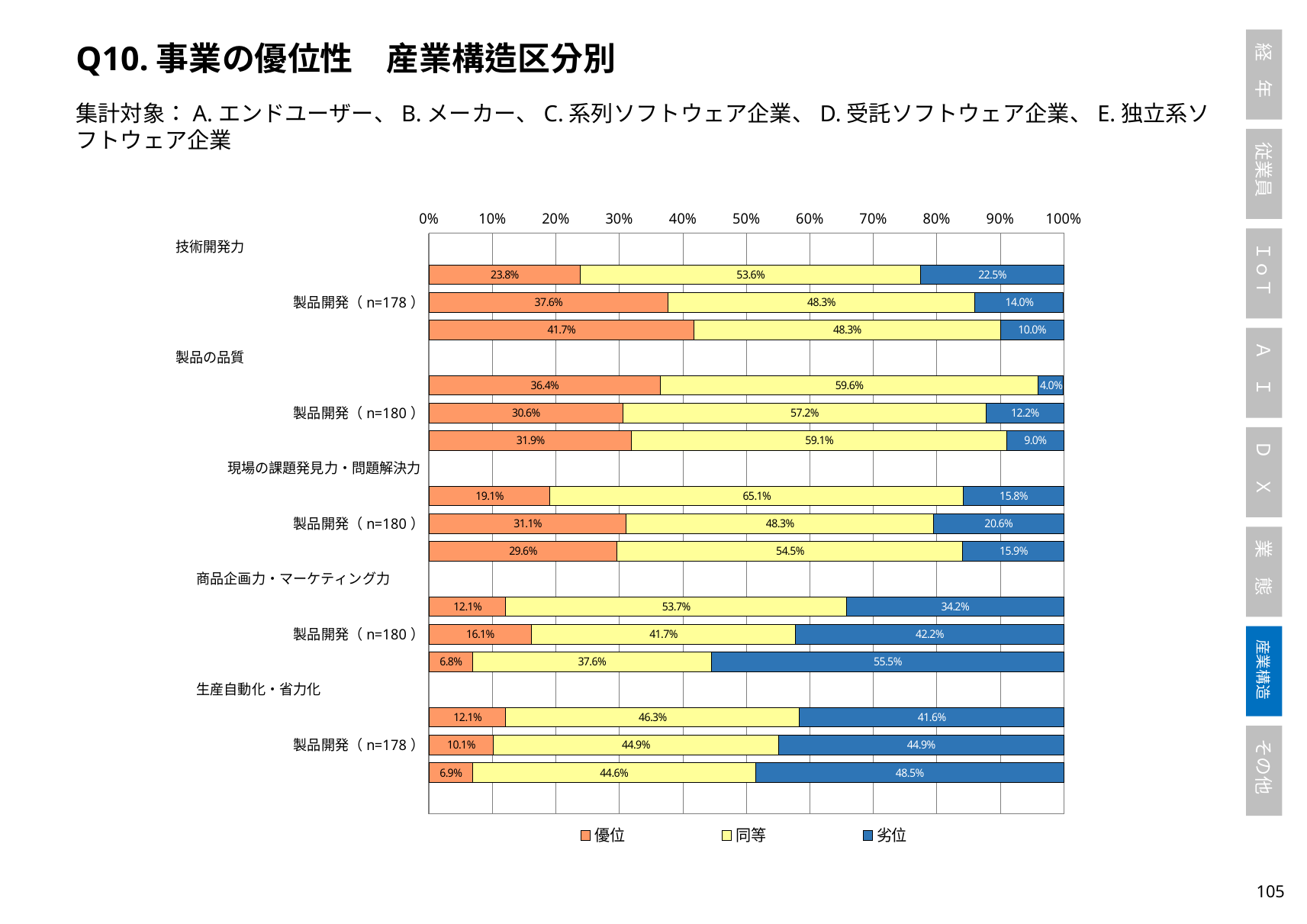
In the 製品の品質 group, what is the 同等 value for the 製品開発 (n=180) bar? 57.2% For the 製品開発 bars, what is the difference between the 劣位 value in 商品企画力・マーケティング力 (42.2%) and in 製品の品質 (12.2%)? 30.0% Among the 製品開発 bars, which category has the highest 優位 value? 技術開発力 Among the 製品開発 bars, which category has the lowest 優位 value? 生産自動化・省力化 In the 現場の課題発見力・問題解決力 group, what is the 劣位 value for the 製品開発 (n=180) bar? 20.6% What kind of chart is shown on the slide? stacked bar chart How many series does the legend list? 3 In the 生産自動化・省力化 group, what is the 優位 value for the 製品開発 (n=178) bar? 10.1% What are the three legend entries? 優位, 同等, 劣位 In the 商品企画力・マーケティング力 group, what is the 劣位 value for the 製品開発 (n=180) bar? 42.2% For the 製品開発 (n=180) bar in 製品の品質, which is larger: the 優位 value or the 劣位 value? 優位 In the 技術開発力 group, what is the 優位 value for the 製品開発 (n=178) bar? 37.6%